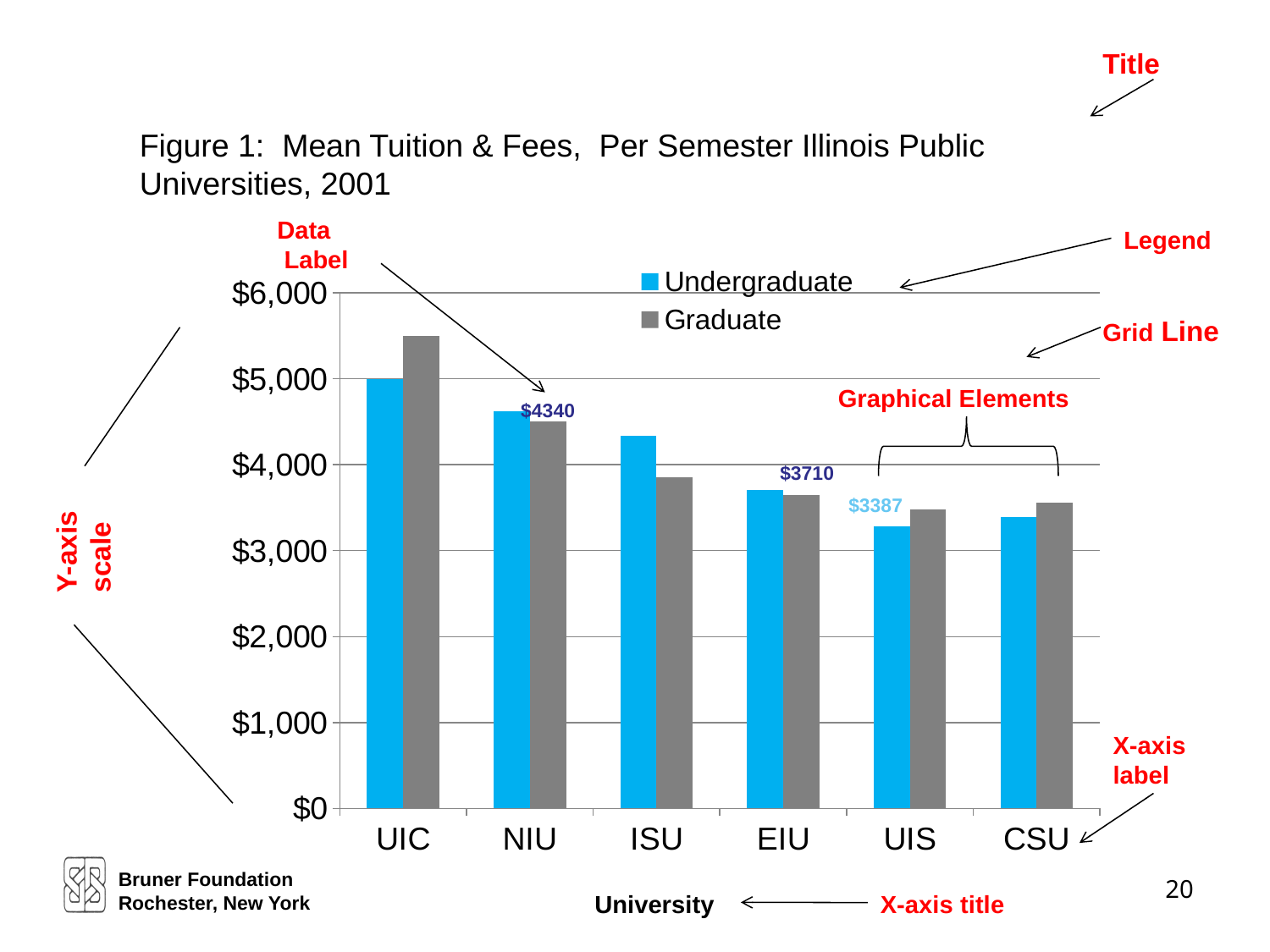
What data label is printed at the NIU bars? $4340 Is the Graduate value for ISU greater or less than $4,000? less What are the two series named in the legend? Undergraduate and Graduate How many universities are shown on the x axis of the chart? 6 Is the Graduate value for UIC greater or less than $5,000? greater What is the Undergraduate value for UIC? $5,000 What data label is printed at the UIS bars? $3387 Which university has the highest Graduate value? UIC What kind of chart is shown on the slide? bar chart Which university has the lowest Undergraduate value? UIS How many series does the chart's legend list? 2 What is the x-axis title of the chart? University